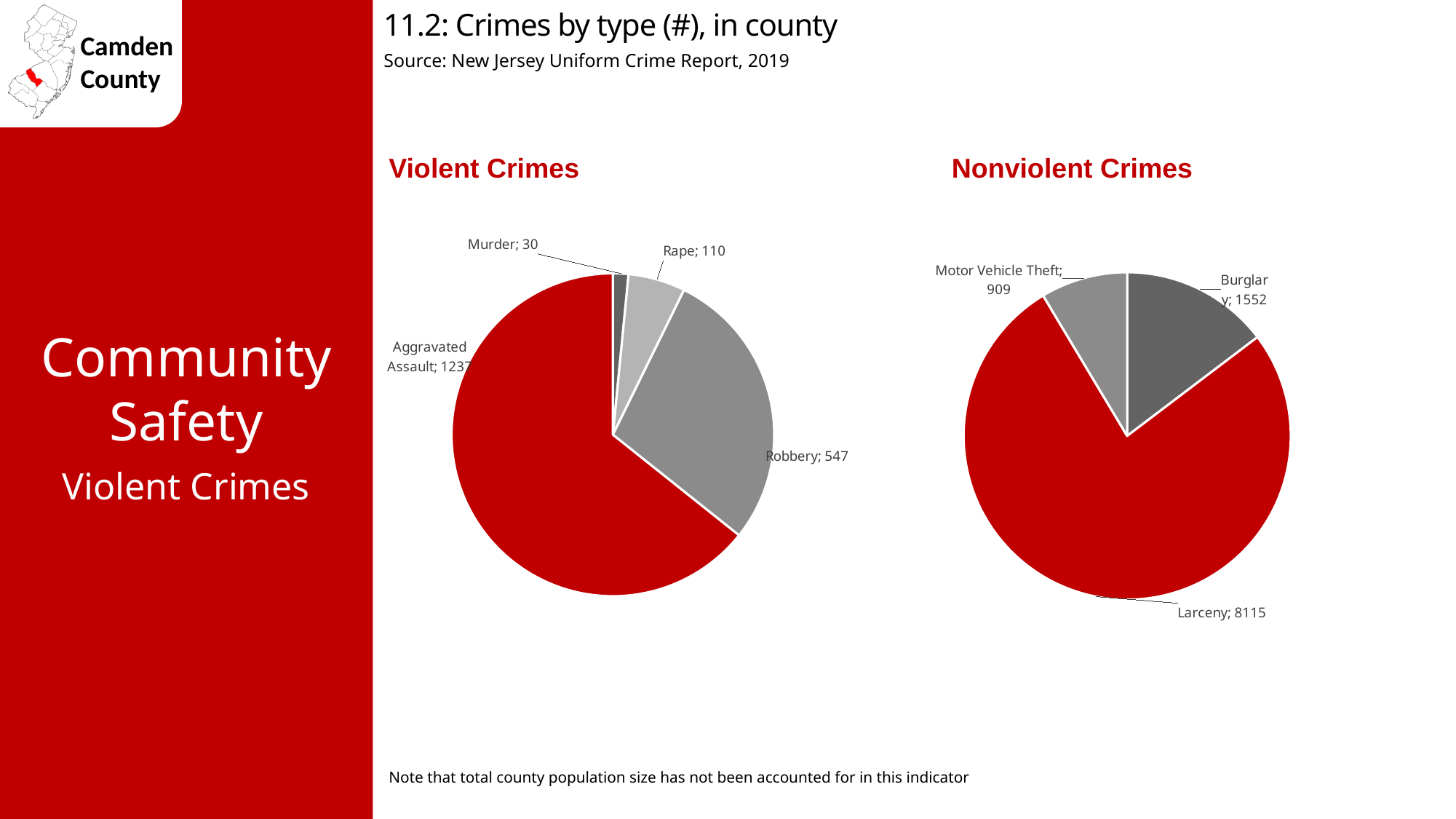
On the Violent Crimes chart, how many murders are shown? 30 On the Nonviolent Crimes chart, what is the value for Larceny? 8115 On the Violent Crimes chart, which crime type has the largest slice? Aggravated Assault On the Nonviolent Crimes chart, what is the difference between Burglary and Motor Vehicle Theft? 643 What kind of chart is used for Violent Crimes? Pie chart On the Violent Crimes chart, what is the difference between Robbery and Rape? 437 On the Violent Crimes chart, what is the value for Robbery? 547 On the Nonviolent Crimes chart, which crime type has the smallest slice? Motor Vehicle Theft On the Nonviolent Crimes chart, what is the value for Motor Vehicle Theft? 909 How many crime types are shown on the Nonviolent Crimes chart? 3 On the Violent Crimes chart, which crime type has the smallest slice? Murder On the Violent Crimes chart, which is larger, Rape or Robbery? Robbery